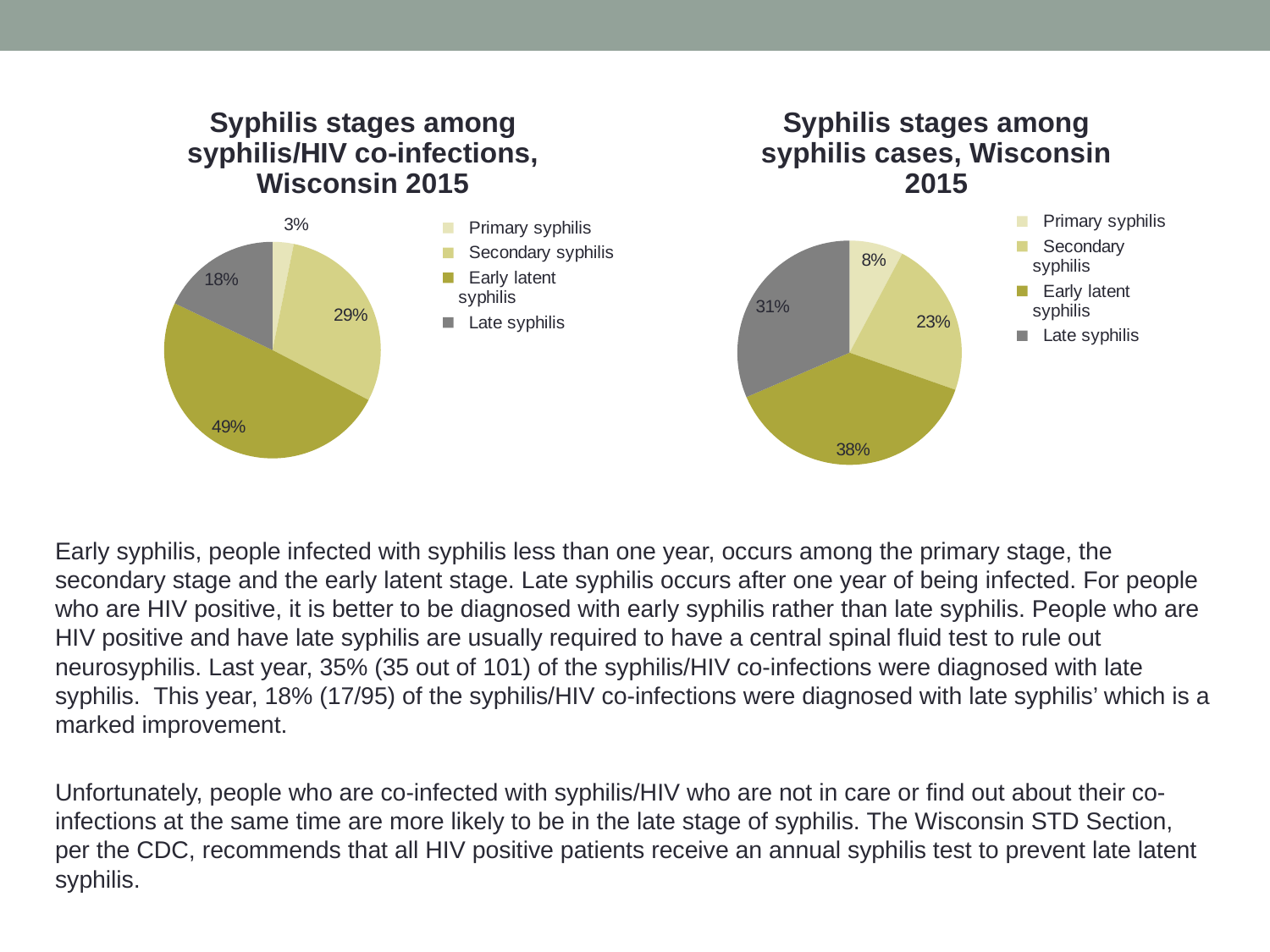
In the 'Syphilis stages among syphilis/HIV co-infections, Wisconsin 2015' chart, what share is Primary syphilis? 3% How many entries does the legend of the 'Syphilis stages among syphilis cases, Wisconsin 2015' chart list? 4 In the 'Syphilis stages among syphilis cases, Wisconsin 2015' chart, which stage has the smallest slice? Primary syphilis What type of chart is used for 'Syphilis stages among syphilis/HIV co-infections, Wisconsin 2015'? Pie chart In the 'Syphilis stages among syphilis/HIV co-infections, Wisconsin 2015' chart, which stage has the largest slice? Early latent syphilis How many slices does the 'Syphilis stages among syphilis cases, Wisconsin 2015' pie chart have? 4 In the 'Syphilis stages among syphilis cases, Wisconsin 2015' chart, what share is Secondary syphilis? 23% In the 'Syphilis stages among syphilis/HIV co-infections, Wisconsin 2015' chart, what share is Early latent syphilis? 49% In the 'Syphilis stages among syphilis cases, Wisconsin 2015' chart, which is larger: Early latent syphilis or Late syphilis? Early latent syphilis In the 'Syphilis stages among syphilis cases, Wisconsin 2015' chart, what share is Late syphilis? 31% In the 'Syphilis stages among syphilis/HIV co-infections, Wisconsin 2015' chart, what is the difference between the Secondary syphilis and Late syphilis shares? 11% In the 'Syphilis stages among syphilis cases, Wisconsin 2015' chart, what is the difference between the Early latent syphilis and Primary syphilis shares? 30%